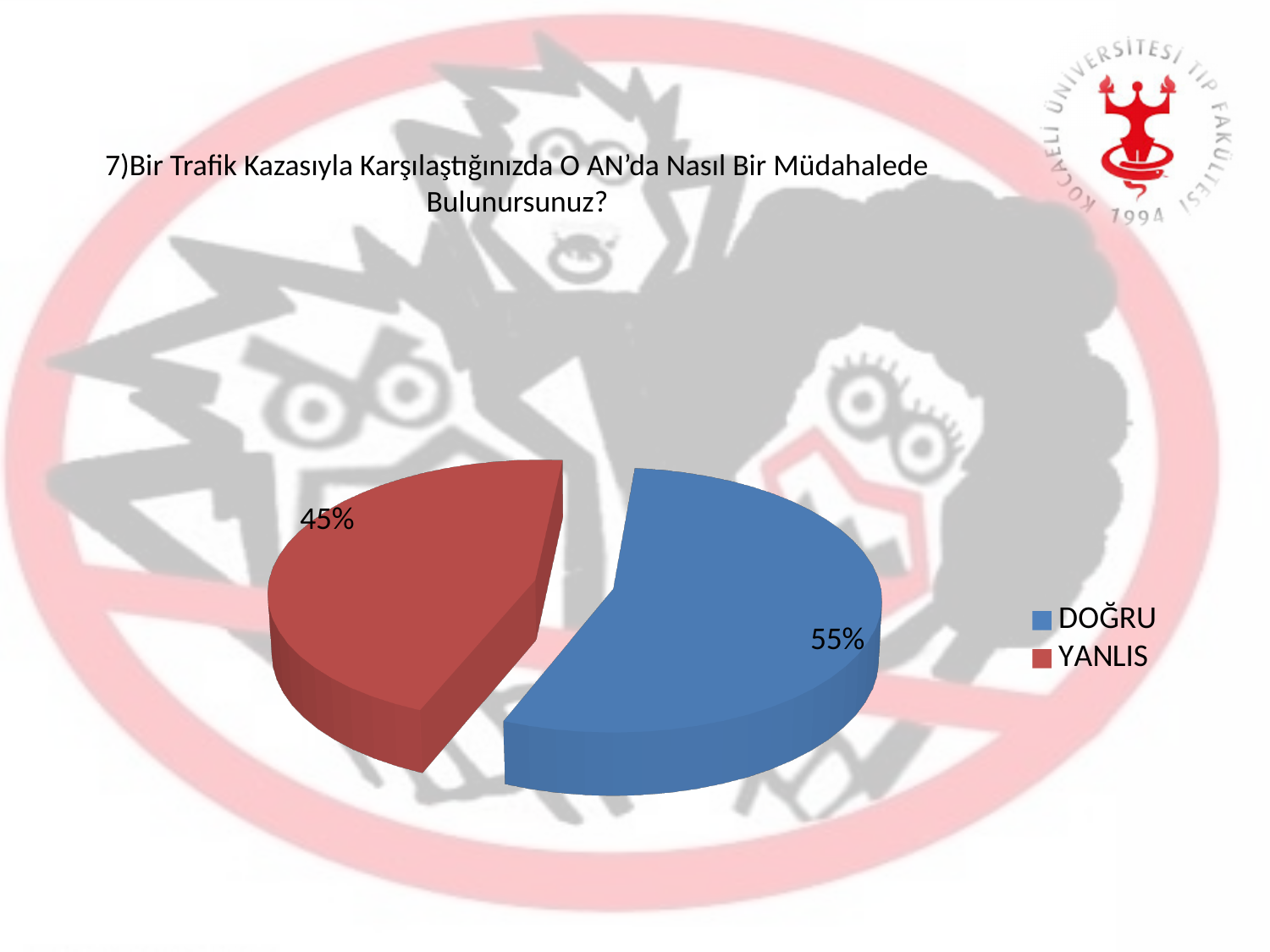
Which is larger, the DOĞRU slice or the YANLIS slice? DOĞRU What colour is the YANLIS slice? red What colour is the DOĞRU slice? blue What is the difference in percentage points between the DOĞRU and YANLIS slices? 10% How many slices does the pie chart have? 2 How many entries does the legend list? 2 Which category has the largest slice of the pie? DOĞRU What kind of chart is shown on the slide? pie chart What share of the pie does YANLIS have? 45% What share of the pie does DOĞRU have? 55% Which category has the smallest slice of the pie? YANLIS